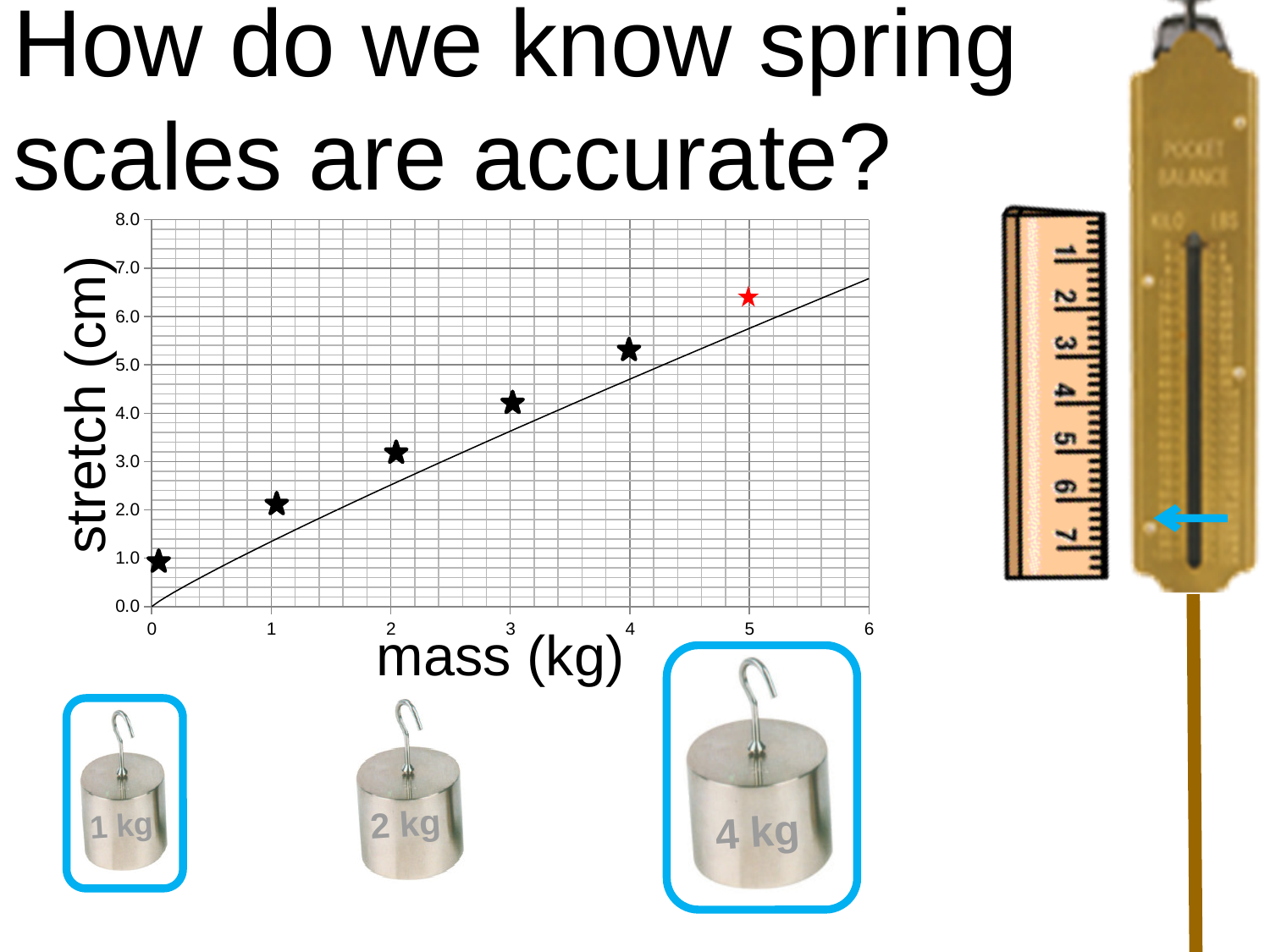
Does the stretch rise or fall as mass increases along the x axis? rise What is the label of the horizontal axis of the chart? mass (kg) Which has the larger plotted stretch, 4 kg or 2 kg? 4 kg Is the stretch plotted at 5 kg greater or less than 6.0 cm? greater Is the stretch plotted at 5 kg greater or less than 7.0 cm? less Is the stretch plotted at 4 kg greater or less than 5.0 cm? greater At which mass is the plotted stretch lowest? 0 kg What is the label of the vertical axis of the chart? stretch (cm) What kind of chart is shown on the slide? scatter plot How many data points (stars) are plotted on the chart? 6 At which mass is the plotted stretch highest? 5 kg